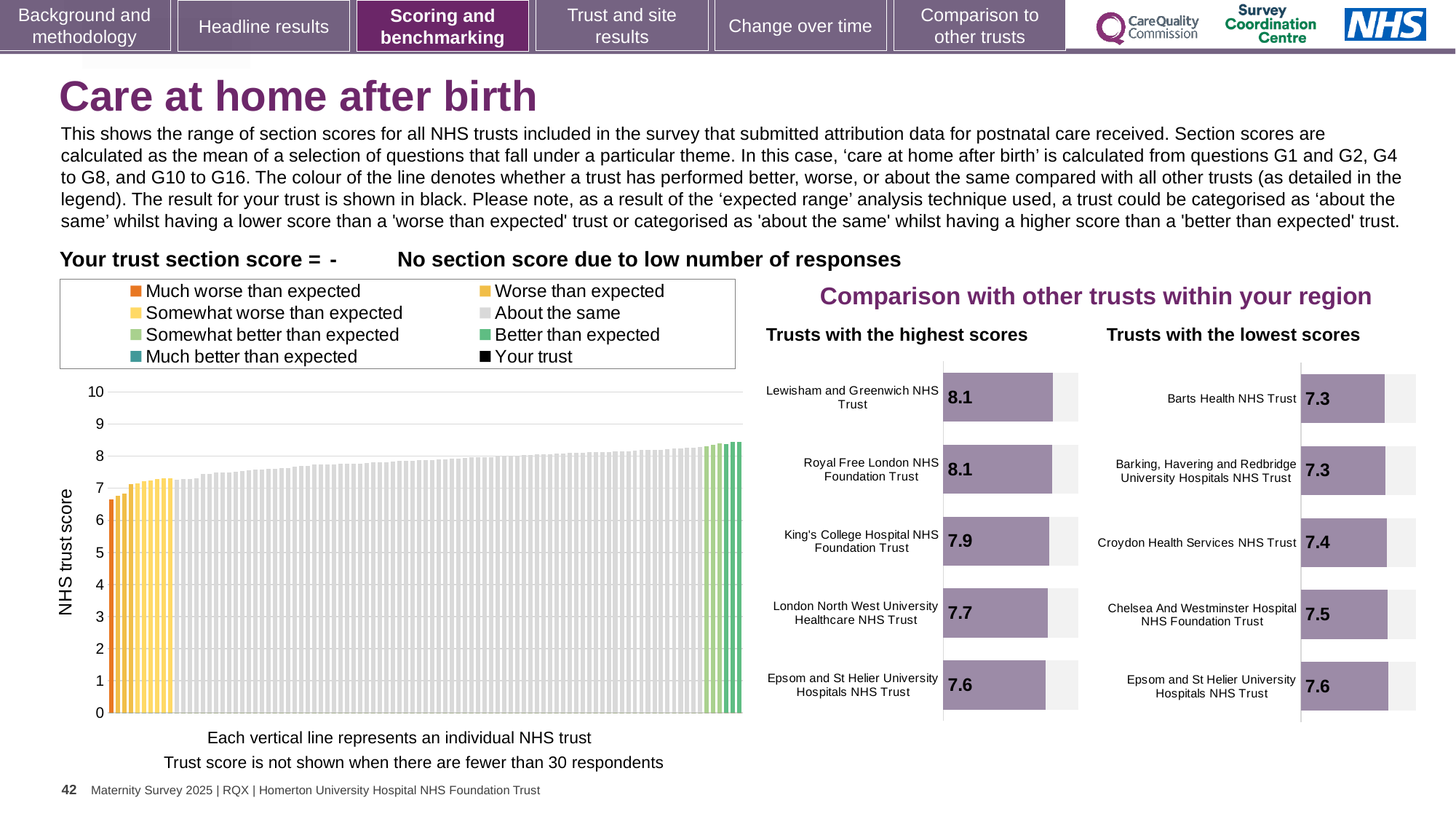
In the 'Trusts with the highest scores' chart, what is the difference between the scores of Lewisham and Greenwich NHS Trust and Epsom and St Helier University Hospitals NHS Trust? 0.5 In the 'Trusts with the lowest scores' chart, which trust has the highest score shown? Epsom and St Helier University Hospitals NHS Trust In the main 'NHS trust score' chart, is the value of the leftmost bar greater or less than 6? greater In the 'Trusts with the lowest scores' chart, what is the score for Croydon Health Services NHS Trust? 7.4 How many entries does the legend of the main NHS trust score chart list? 8 In the 'Trusts with the highest scores' chart, what is the score for King's College Hospital NHS Foundation Trust? 7.9 In the 'Trusts with the highest scores' chart, which trust has the lowest score shown? Epsom and St Helier University Hospitals NHS Trust In the 'Trusts with the lowest scores' chart, which has the larger score: Barts Health NHS Trust or Chelsea And Westminster Hospital NHS Foundation Trust? Chelsea And Westminster Hospital NHS Foundation Trust In the 'Trusts with the highest scores' chart, what is the score for London North West University Healthcare NHS Trust? 7.7 What kind of chart is the main 'NHS trust score' chart on the left of the slide? Bar chart In the main 'NHS trust score' chart, do the bar values rise or fall from left to right? Rise How many trusts are listed in the 'Trusts with the lowest scores' chart? 5